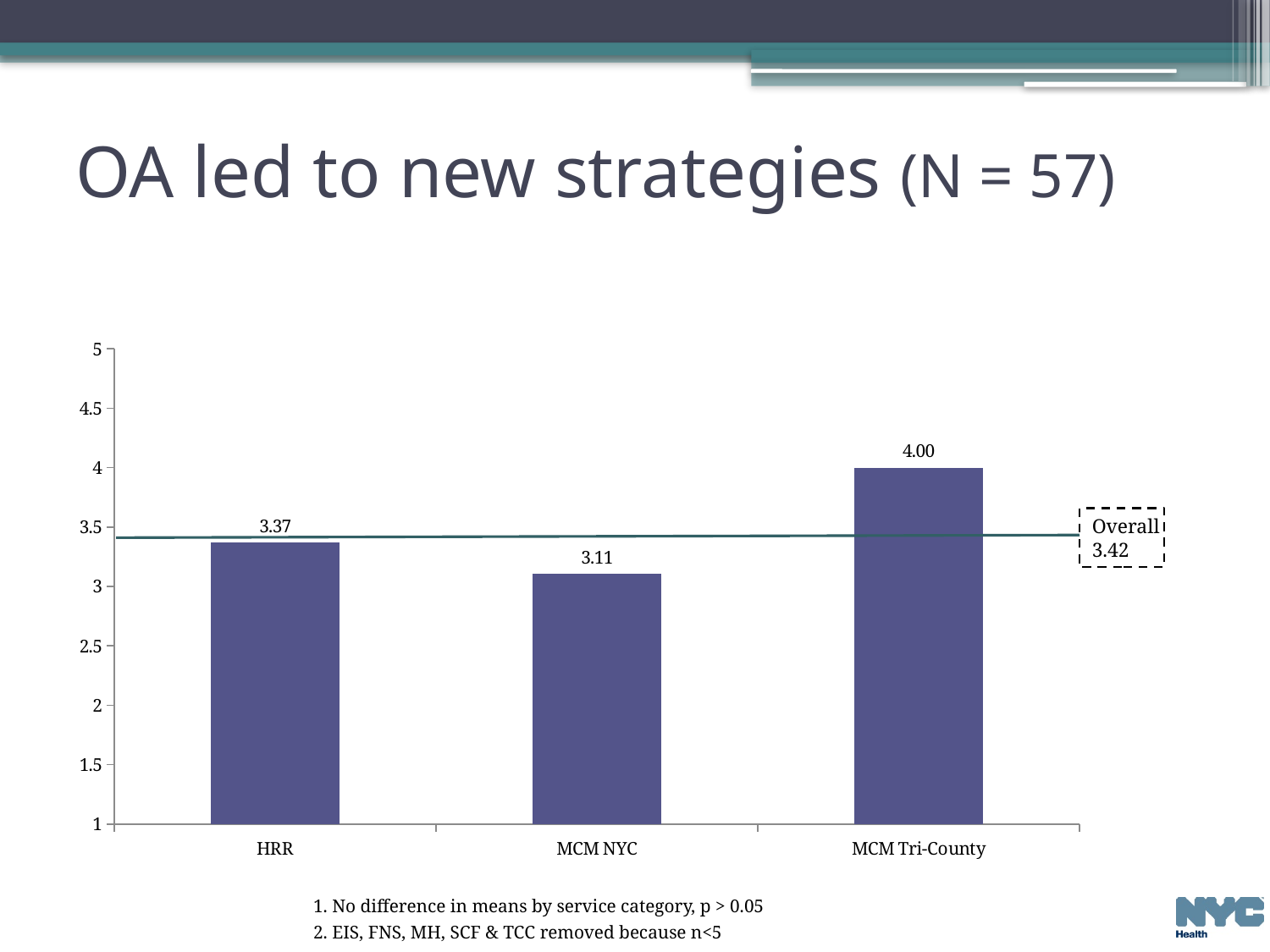
What is the value for HRR? 3.37 How many categories are shown on the x axis? 3 What is the value for MCM NYC? 3.11 Is the value for MCM NYC greater or less than 3.5? less Which is larger, the value for HRR or the value for MCM NYC? HRR Which category has the lowest value? MCM NYC What is the difference between the values for MCM Tri-County and MCM NYC? 0.89 What is the difference between the values for HRR and MCM NYC? 0.26 What is the value for MCM Tri-County? 4.00 What overall value is marked by the horizontal line on the chart? 3.42 Which category has the highest value? MCM Tri-County What kind of chart is shown on the slide? bar chart